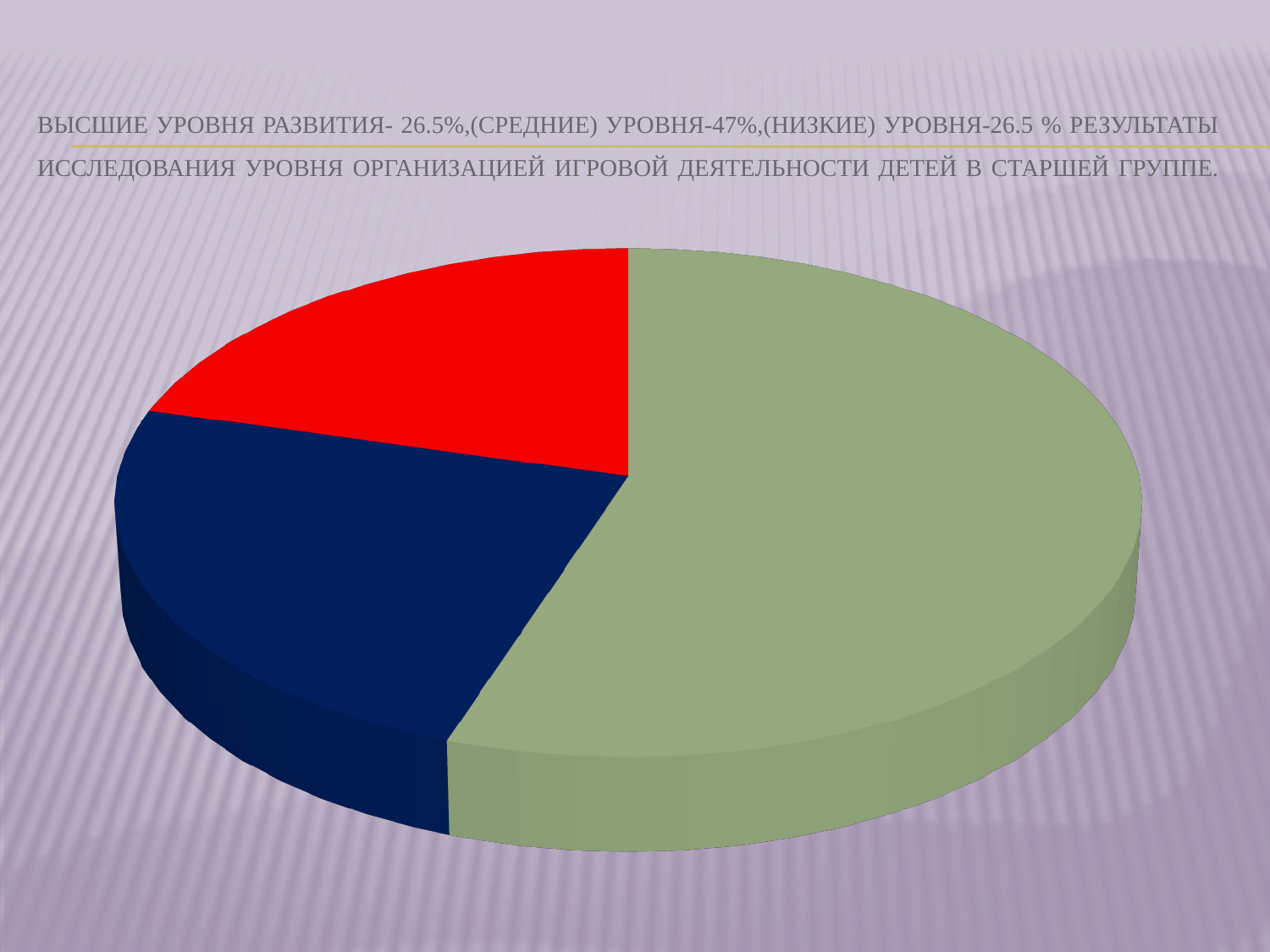
Is the green slice larger than the dark blue slice? yes How many slices does the pie chart have? 3 According to the slide text, what percentage corresponds to the средний (middle) level? 47% Which colour slice is the largest in the pie chart? green Is the green slice of the pie chart greater or less than half of the pie? greater What kind of chart is shown on the slide? pie chart Is the green slice larger than the red slice? yes Does the pie chart display a legend? no Is the red slice of the pie chart greater or less than half of the pie? less According to the slide text, what percentage corresponds to the высший (high) level of development? 26.5%